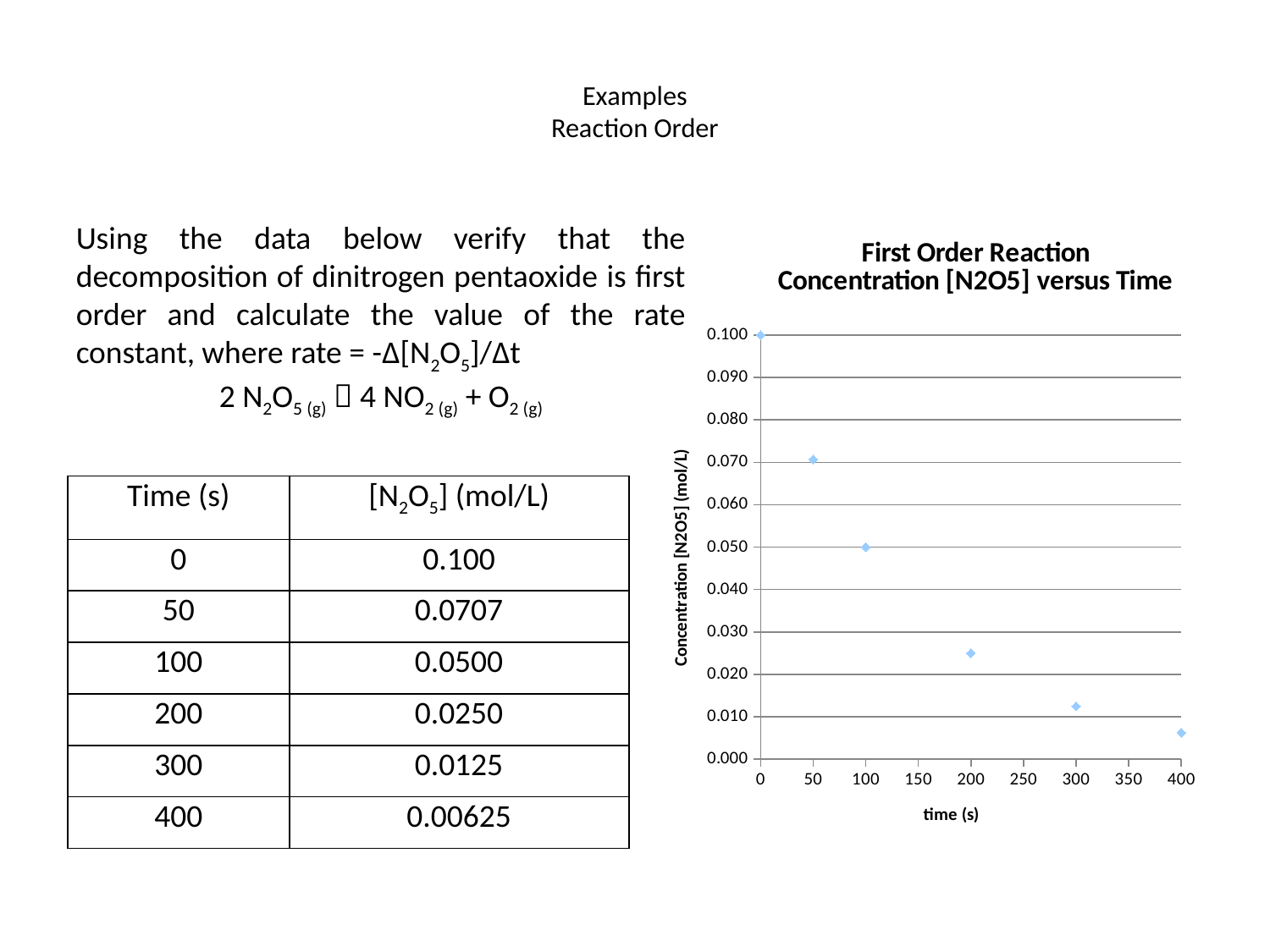
Do the plotted concentration values rise or fall as time increases? fall At which time is the plotted concentration lowest? 400 At which time is the plotted concentration highest? 0 What is the concentration plotted at time 200 s? 0.0250 What is the label of the x axis of the chart? time (s) How many data points are plotted on the chart? 6 What is the concentration plotted at time 0 s? 0.100 What kind of chart is shown on the slide? scatter chart What is the concentration plotted at time 100 s? 0.0500 What is the title of the chart? First Order Reaction Concentration [N2O5] versus Time Is the concentration at 300 s greater or less than 0.020? less Is the concentration at 50 s greater or less than 0.060? greater